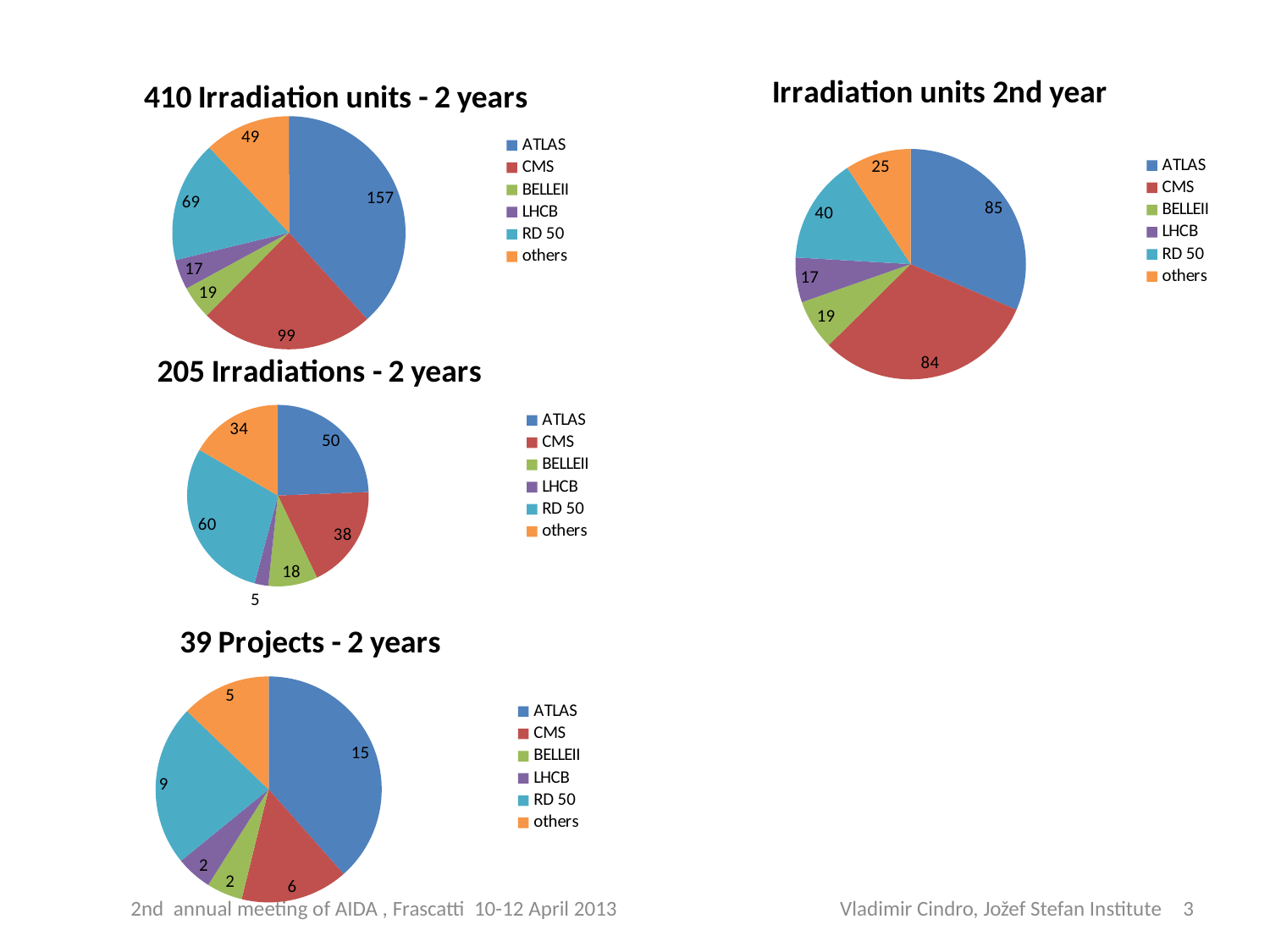
In the '39 Projects - 2 years' chart, which colour represents CMS? Red In the '410 Irradiation units - 2 years' chart, what is the value for ATLAS? 157 In the '410 Irradiation units - 2 years' chart, what is the value for RD 50? 69 In the 'Irradiation units 2nd year' chart, what is the value for CMS? 84 In the '39 Projects - 2 years' chart, what is the difference between the ATLAS value and the RD 50 value? 6 How many slices does the '39 Projects - 2 years' chart have? 6 In the '205 Irradiations - 2 years' chart, which category has the lowest value? LHCB In the 'Irradiation units 2nd year' chart, which is larger, the value for RD 50 or the value for others? RD 50 What kind of chart is the '205 Irradiations - 2 years' chart? Pie chart In the '410 Irradiation units - 2 years' chart, what is the difference between the CMS value and the others value? 50 How many entries does the legend of the 'Irradiation units 2nd year' chart list? 6 In the '205 Irradiations - 2 years' chart, which category has the highest value? RD 50